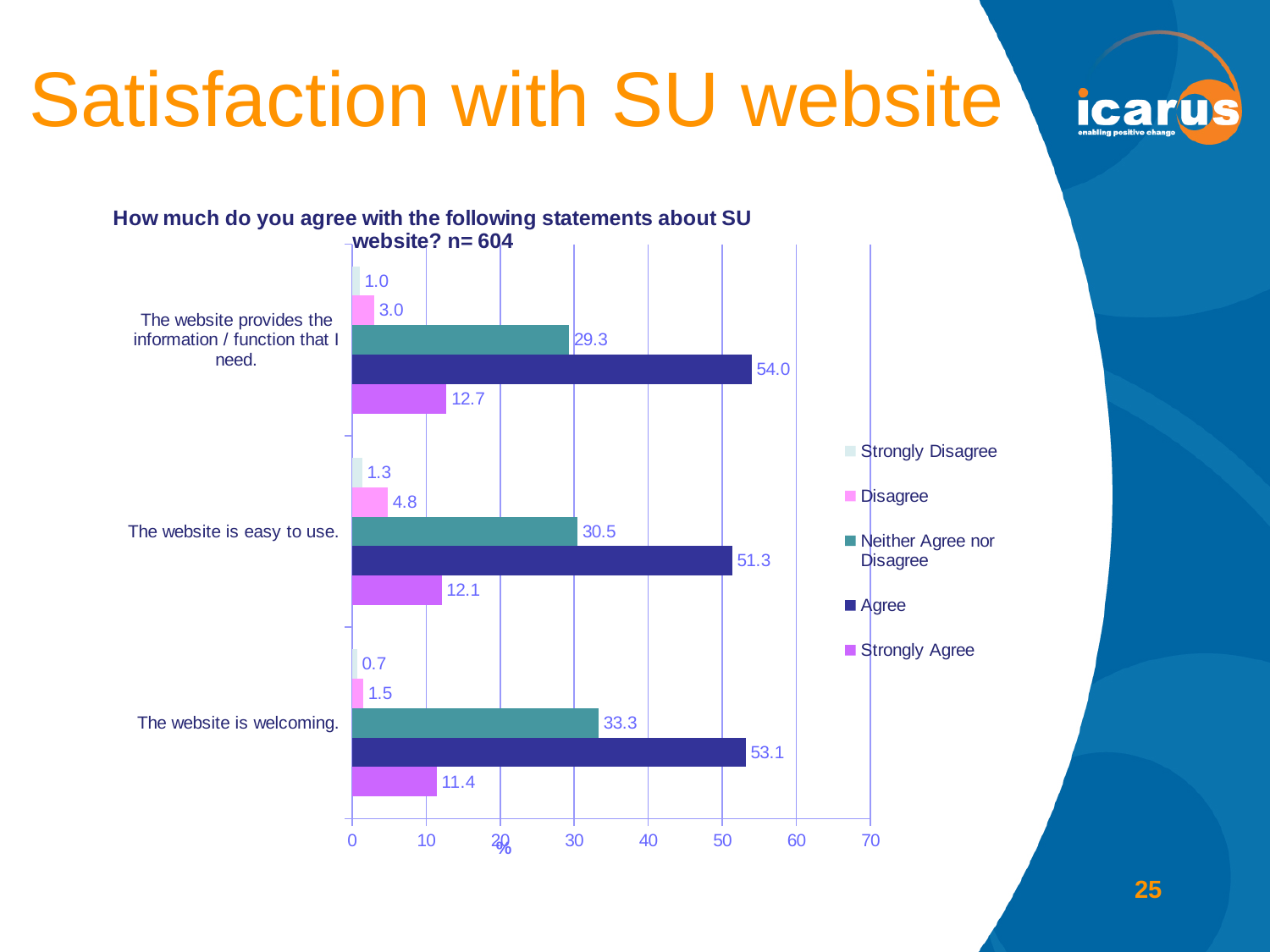
What is the 'Neither Agree nor Disagree' value for 'The website is easy to use.'? 30.5 What is the 'Strongly Disagree' value for 'The website is welcoming.'? 0.7 Which statement has the lowest 'Disagree' value? The website is welcoming. What is the 'Strongly Agree' value for 'The website is welcoming.'? 11.4 What type of chart is shown on the slide? Bar chart What percentage of respondents agree that the website provides the information / function that they need? 54.0 What is the difference between the 'Agree' and 'Neither Agree nor Disagree' values for 'The website is easy to use.'? 20.8 How many series does the legend list? 5 Which statement has the highest 'Agree' value? The website provides the information / function that I need. How many statements (categories) are shown on the chart? 3 What is the sample size (n) given in the chart title? 604 Which is larger: the 'Strongly Agree' value for 'The website provides the information / function that I need.' or for 'The website is easy to use.'? The website provides the information / function that I need.